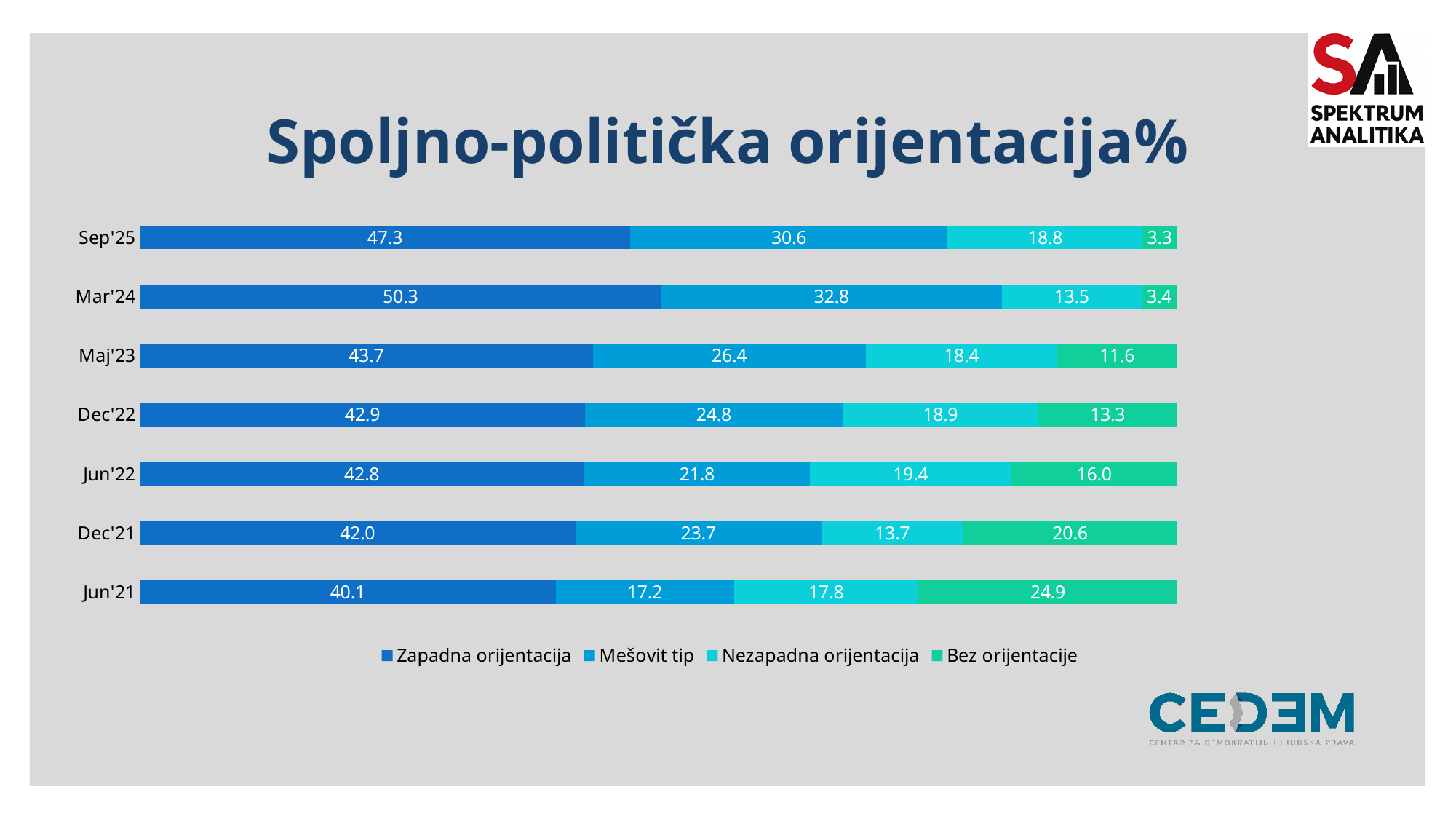
What is the value for Bez orijentacije in Jun'21? 24.9 Which is larger: Nezapadna orijentacija in Jun'22 or in Dec'21? Jun'22 In which period is Mešovit tip lowest? Jun'21 What kind of chart is shown on the slide? Stacked bar chart How many series does the legend list? 4 Does the value for Bez orijentacije rise or fall from Jun'21 to Sep'25? Fall What is the value for Zapadna orijentacija in Sep'25? 47.3 What is the difference between Zapadna orijentacija in Mar'24 and in Jun'21? 10.2 What is the value for Nezapadna orijentacija in Dec'22? 18.9 In which period is Zapadna orijentacija highest? Mar'24 What is the value for Mešovit tip in Mar'24? 32.8 How many periods are shown on the chart? 7